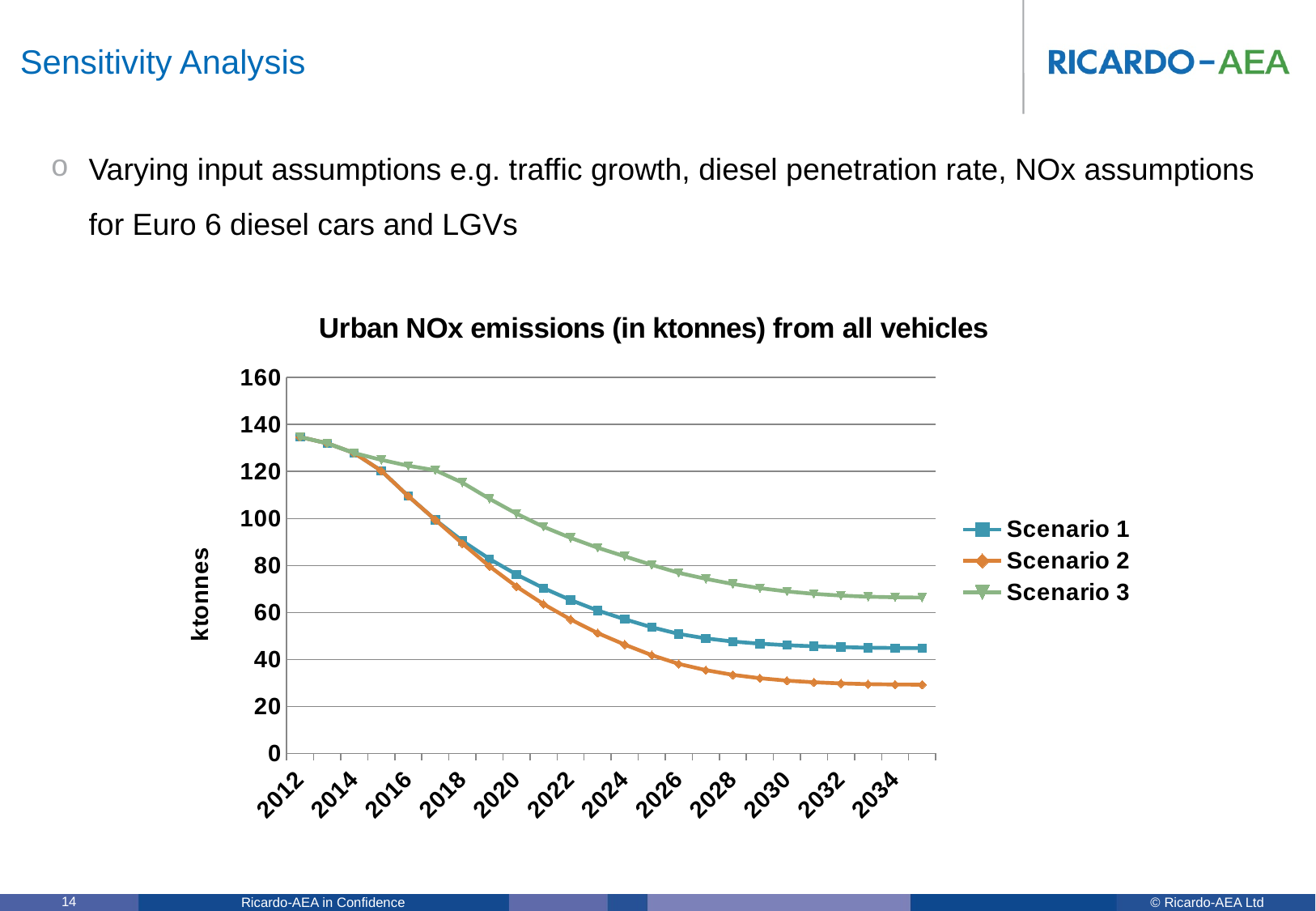
What is the label on the vertical axis of the chart? ktonnes Is the value for Scenario 3 in 2034 greater or less than 60? greater What is the title of the chart? Urban NOx emissions (in ktonnes) from all vehicles What kind of chart is shown on the slide? Line chart Which scenario has the lowest value in 2034? Scenario 2 Is the value for Scenario 2 in 2034 greater or less than 40? less Which scenario has the highest value in 2034? Scenario 3 In 2030, which is larger: the value for Scenario 3 or the value for Scenario 2? Scenario 3 Is the value for Scenario 1 in 2034 greater or less than 60? less How many series does the legend list? 3 Do the values for Scenario 1 rise or fall from 2012 to 2034? Fall